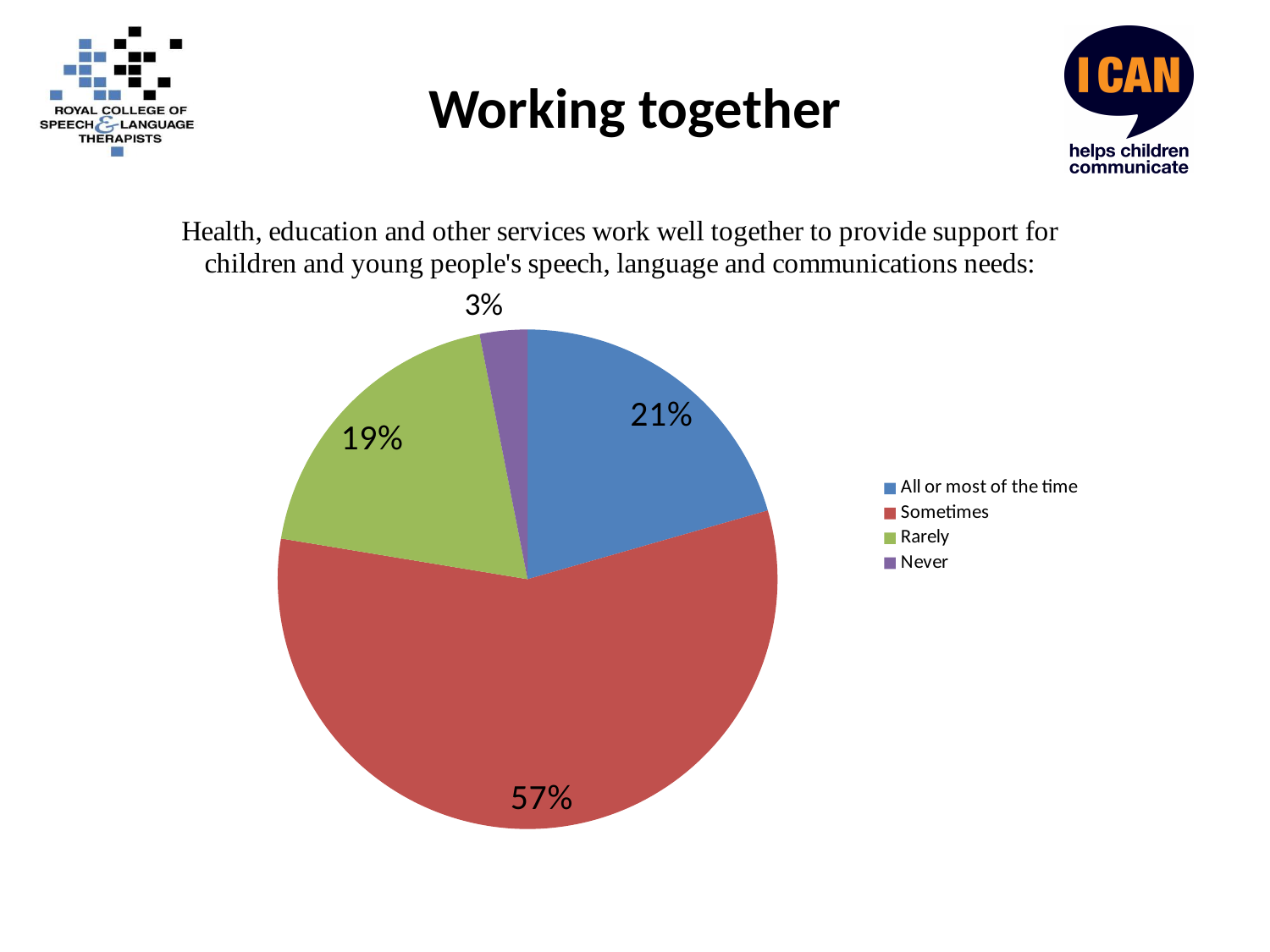
What is the title of the slide containing the chart? Working together Which category has the smallest share of the pie? Never What percentage of the pie is 'Sometimes'? 57% What percentage of the pie is 'Never'? 3% What percentage of the pie is 'All or most of the time'? 21% What percentage of the pie is 'Rarely'? 19% What is the difference in percentage points between 'Sometimes' and 'All or most of the time'? 36 What colour is the 'Sometimes' slice? red What kind of chart is shown on the slide? pie chart Which is larger, the share for 'Rarely' or the share for 'Never'? Rarely Which category has the largest share of the pie? Sometimes How many categories does the legend list? 4